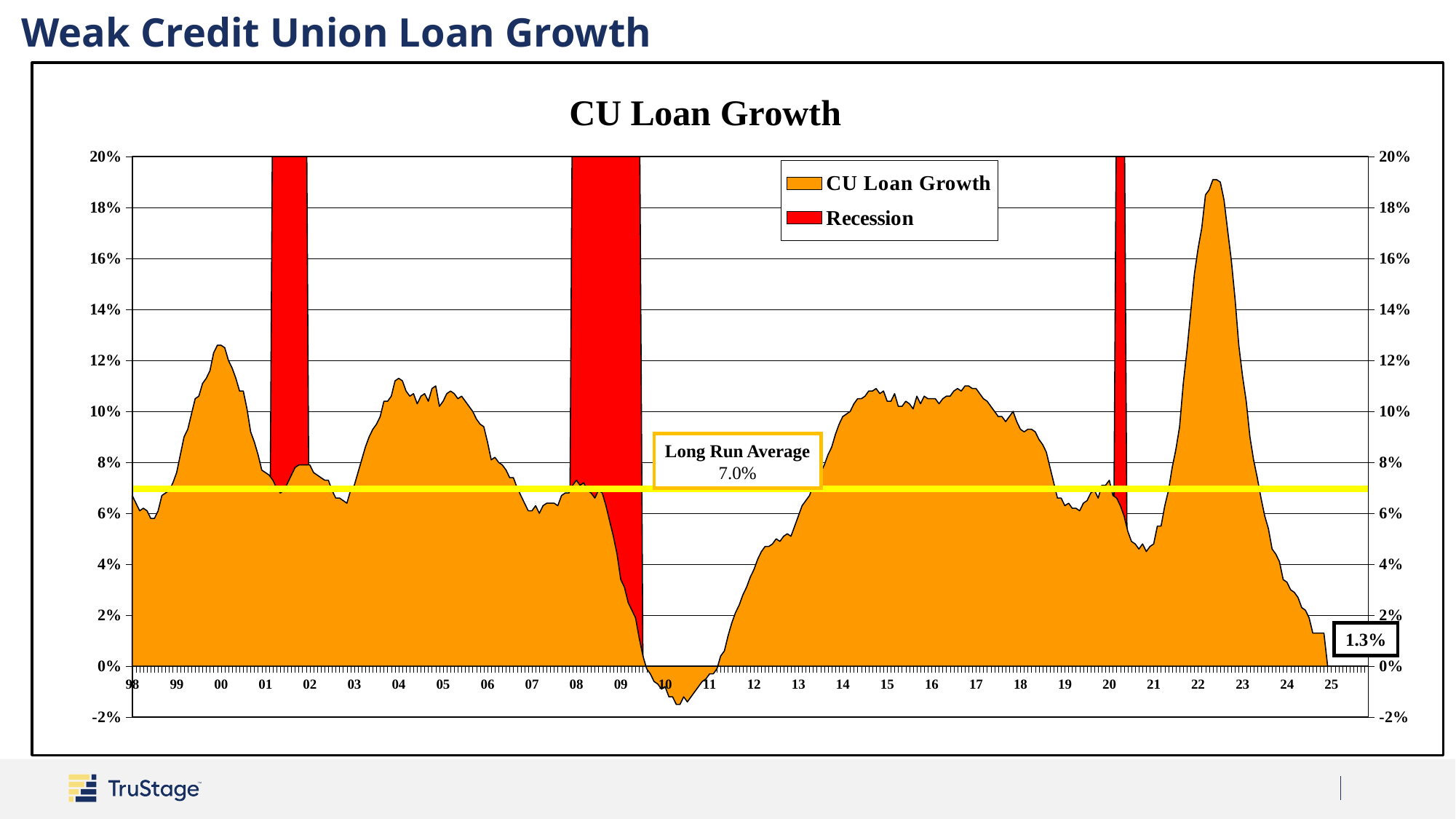
Is the peak CU Loan Growth value around 2022 greater or less than 18%? greater What is the Long Run Average value shown on the chart? 7.0% Around which year does CU Loan Growth reach its lowest point on the chart? 2010 What is the title of the chart? CU Loan Growth Is the CU Loan Growth value around 2000 greater or less than 10%? greater How many recession periods are shaded on the chart? 3 Is the CU Loan Growth value around 2010 greater or less than 0%? less What kind of chart is shown on the slide? area chart What is the most recent CU Loan Growth value labeled on the chart? 1.3% How many entries does the chart legend list? 2 Does CU Loan Growth rise or fall from 2022 to 2025? fall In which year does CU Loan Growth reach its highest peak on the chart? 2022